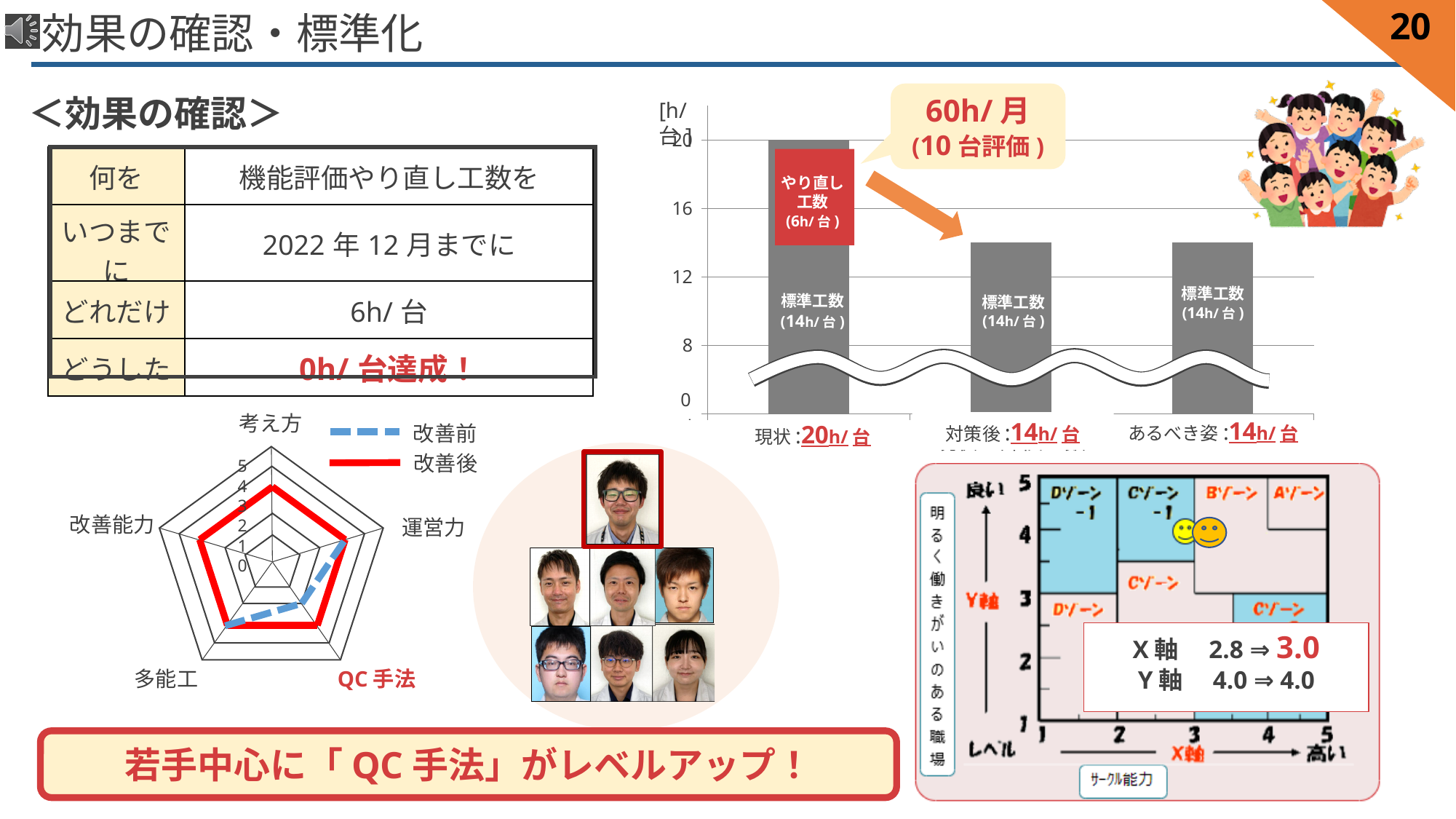
In the bar chart at the top right, which category has the highest value? 現状 In the bar chart at the top right, what is the total of the stacked 現状 bar (標準工数 plus やり直し工数)? 20h/台 In the bar chart at the top right, does the value rise or fall from 現状 to 対策後? fall In the bar chart at the top right, what is the difference between the 現状 value and the 対策後 value? 6h/台 In the bar chart at the top right, what is the 標準工数 value for 対策後? 14h/台 In the bar chart at the top right, what is the value for 現状? 20h/台 In the bar chart at the top right, what is the やり直し工数 portion of the 現状 bar? 6h/台 In the bar chart at the top right, how many categories are shown on the x axis? 3 In the radar chart at the bottom left, how many series does the legend list? 2 What kind of chart is the chart at the top right of the slide? bar chart In the radar chart at the bottom left, how many axes (categories) are there? 5 In the radar chart at the bottom left, which series has the larger value for QC手法, 改善前 or 改善後? 改善後